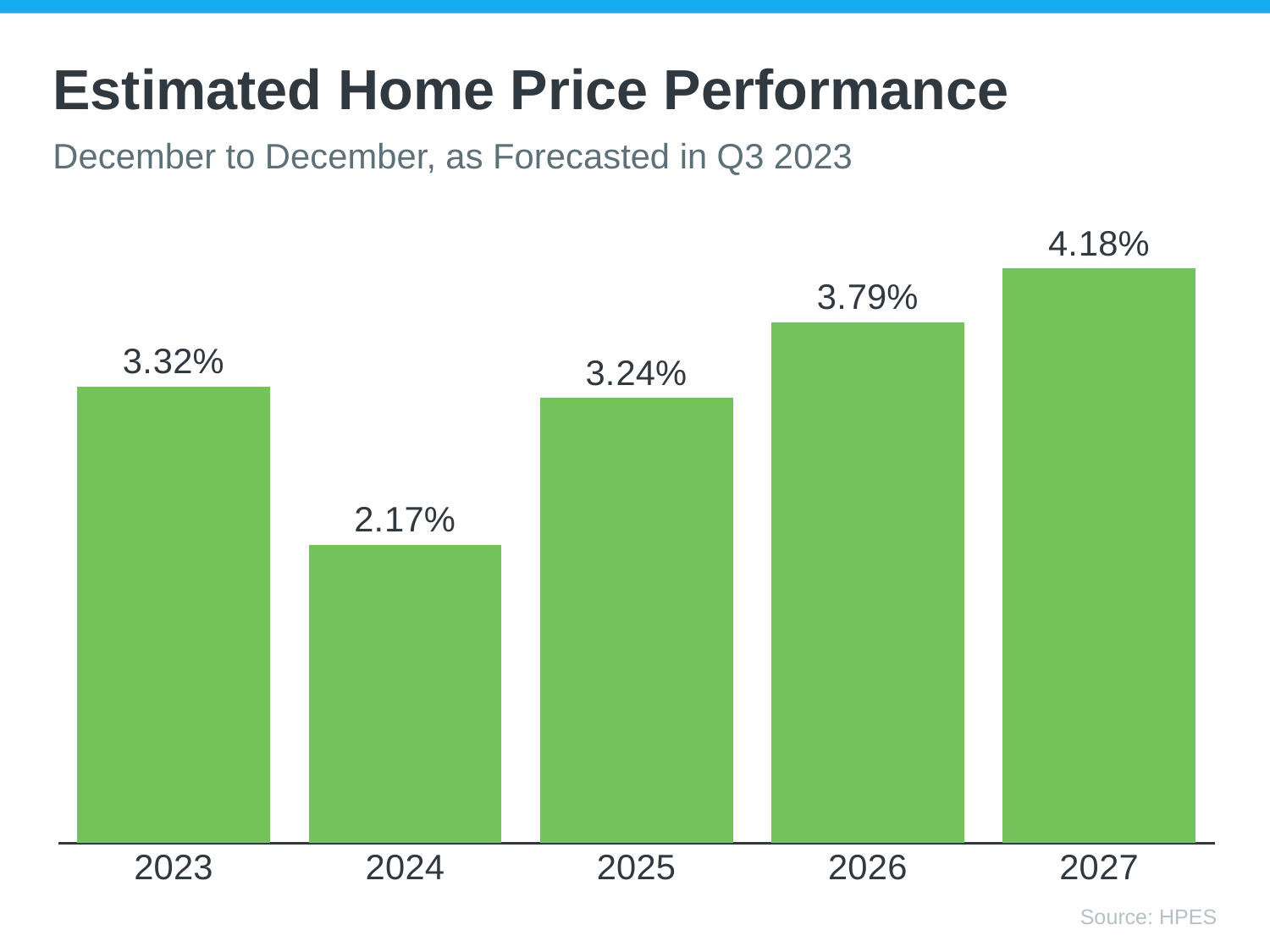
What is the estimated home price performance for 2026? 3.79% What is the estimated home price performance for 2023? 3.32% What is the estimated home price performance for 2024? 2.17% What kind of chart is shown on the slide? Bar chart How many years are shown on the chart? 5 Which year has the lowest estimated home price performance? 2024 Do the values rise or fall from 2024 to 2027? Rise What is the difference between the estimated home price performance for 2027 and 2024? 2.01% Which year has the highest estimated home price performance? 2027 What is the difference between the estimated home price performance for 2026 and 2025? 0.55% Which year has a higher estimated home price performance, 2023 or 2025? 2023 What is the source cited for the chart? HPES